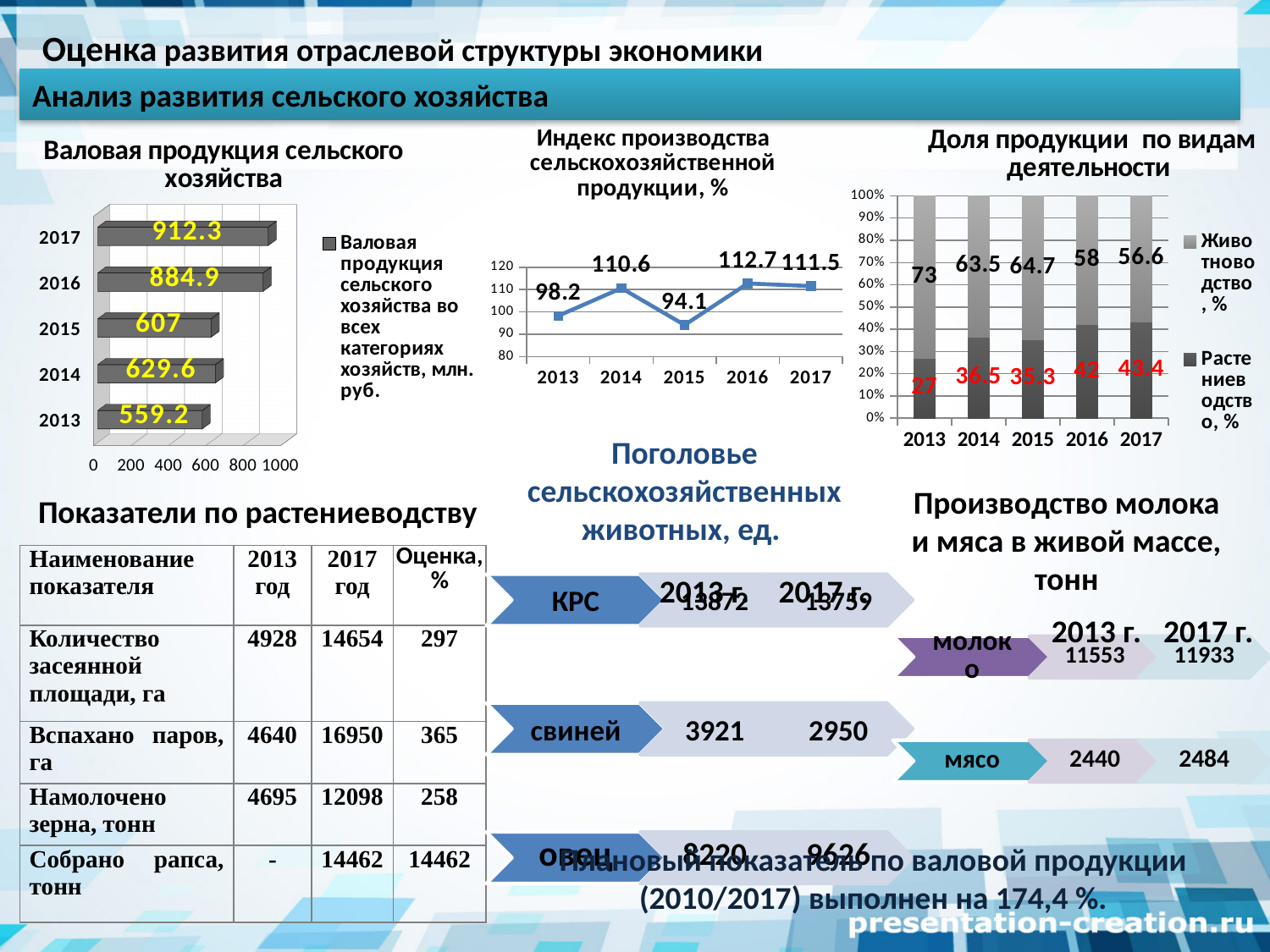
On the chart 'Валовая продукция сельского хозяйства', what is the value for 2017? 912.3 On the chart 'Доля продукции по видам деятельности', does the share of Растениеводство rise or fall from 2013 to 2017? rise How many series does the legend of the chart 'Доля продукции по видам деятельности' list? 2 How many data points are plotted on the chart 'Индекс производства сельскохозяйственной продукции, %'? 5 What kind of chart is 'Индекс производства сельскохозяйственной продукции, %'? line chart On the chart 'Валовая продукция сельского хозяйства', which is larger: the value for 2014 or the value for 2015? 2014 On the chart 'Индекс производства сельскохозяйственной продукции, %', what is the value for 2015? 94.1 On the chart 'Индекс производства сельскохозяйственной продукции, %', which year has the highest value? 2016 On the chart 'Валовая продукция сельского хозяйства', what is the difference between the 2017 and 2013 values? 353.1 On the chart 'Валовая продукция сельского хозяйства', which year has the lowest value? 2013 On the chart 'Доля продукции по видам деятельности', what is the value of Растениеводство for 2013? 27 What kind of chart is 'Валовая продукция сельского хозяйства'? bar chart